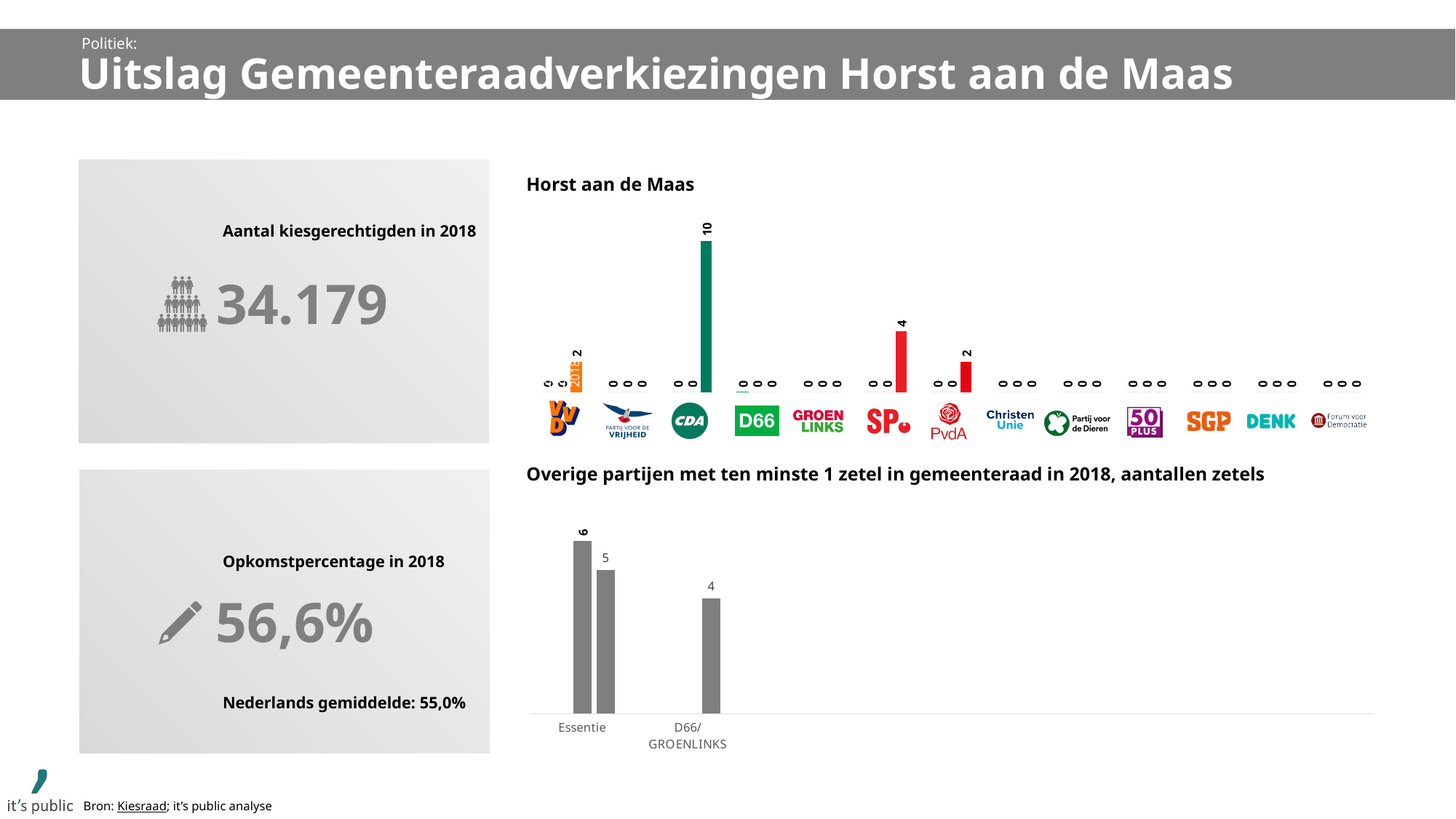
In the 'Horst aan de Maas' chart, how many seats does the CDA bar show? 10 In the 'Horst aan de Maas' chart, what is the difference between the SP value and the PvdA value? 2 In the 'Horst aan de Maas' chart, which is larger, the CDA value or the SP value? CDA How many party logos are shown along the x axis of the 'Horst aan de Maas' chart? 13 In the 'Overige partijen met ten minste 1 zetel' chart, what value is labelled for D66/GROENLINKS? 4 How many categories are labelled on the x axis of the 'Overige partijen met ten minste 1 zetel' chart? 2 In the 'Horst aan de Maas' chart, what value is labelled on the SP bar? 4 In the 'Horst aan de Maas' chart, what is the difference between the CDA value and the SP value? 6 What kind of chart is the 'Horst aan de Maas' chart? bar chart In the 'Horst aan de Maas' chart, which party has the highest bar? CDA In the 'Horst aan de Maas' chart, what value is labelled on the PvdA bar? 2 What is the title of the lower chart on the slide? Overige partijen met ten minste 1 zetel in gemeenteraad in 2018, aantallen zetels